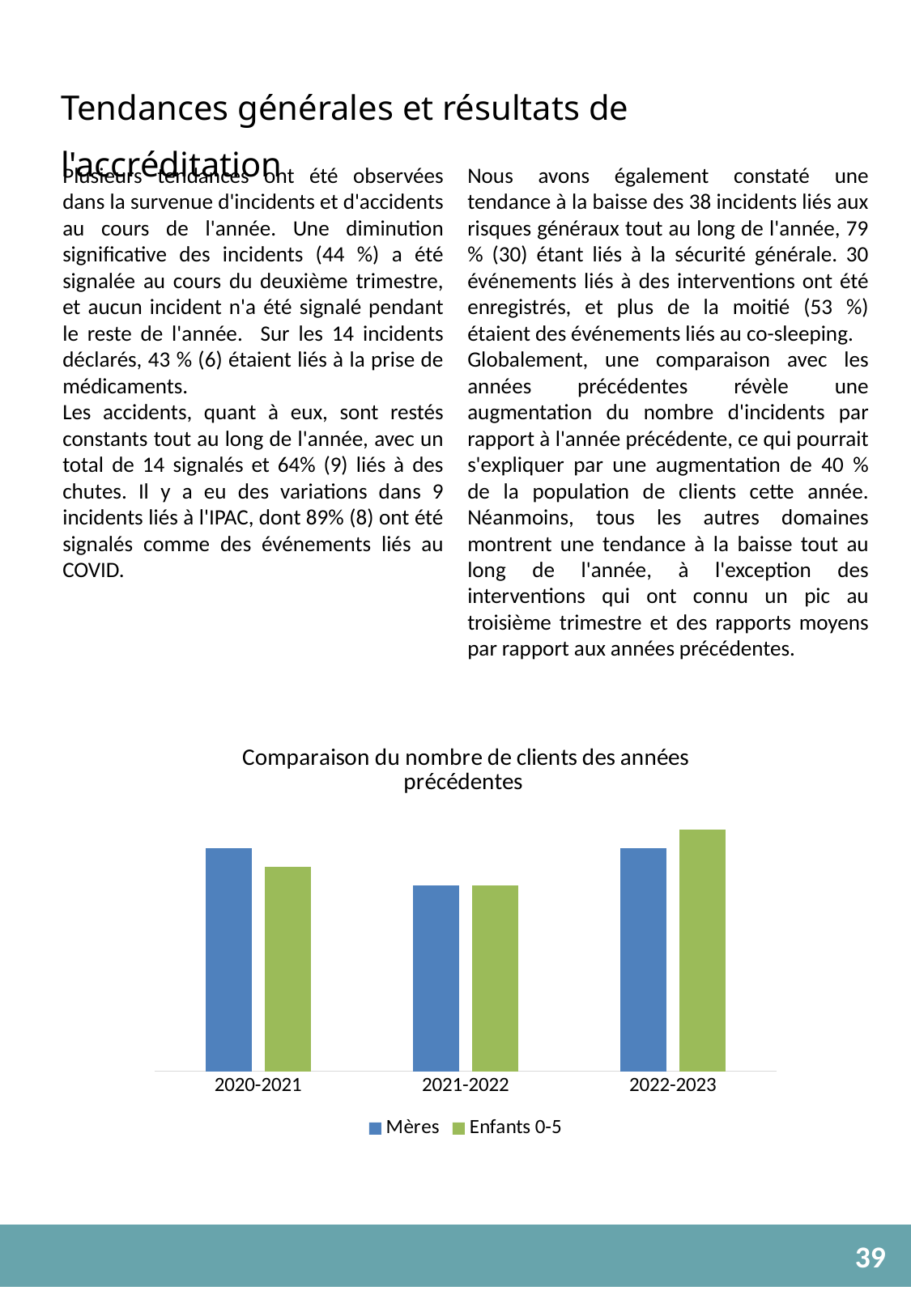
What are the two series named in the legend? Mères and Enfants 0-5 How many year categories are shown on the x axis? 3 How many series does the chart's legend list? 2 What is the title of the chart? Comparaison du nombre de clients des années précédentes For the Enfants 0-5 series, which year has the highest bar? 2022-2023 For the Enfants 0-5 series, is the bar for 2022-2023 taller or shorter than the bar for 2021-2022? taller In 2020-2021, which series has the taller bar, Mères or Enfants 0-5? Mères For the Mères series, which year has the lowest bar? 2021-2022 What kind of chart is shown on the slide? bar chart In 2022-2023, which series has the taller bar, Mères or Enfants 0-5? Enfants 0-5